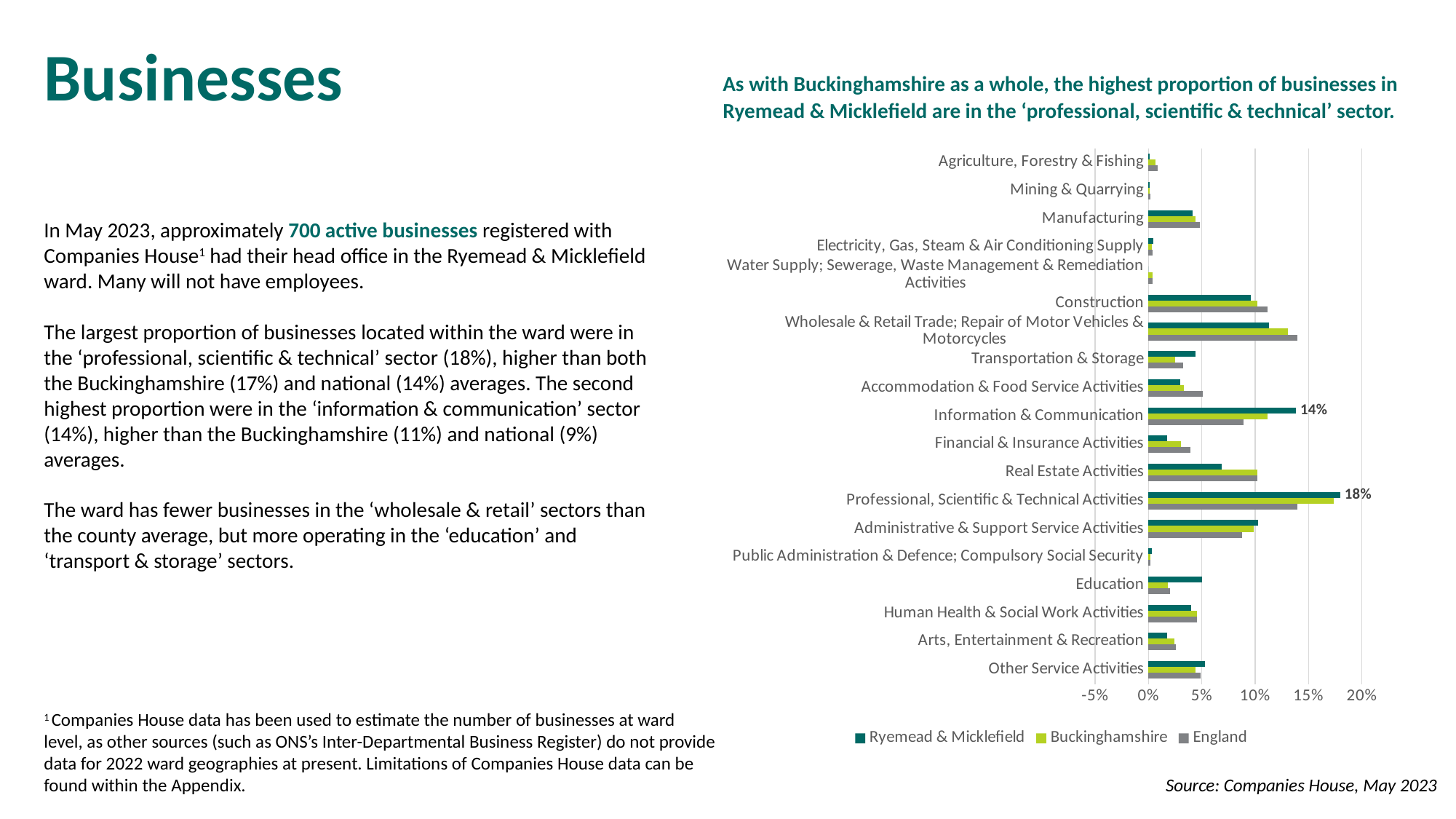
What is the difference between the Ryemead & Micklefield values for Professional, Scientific & Technical Activities and Information & Communication? 4 percentage points How many categories are shown on the chart? 19 Is the Ryemead & Micklefield value for Construction greater or less than 5%? greater Is the England value for Wholesale & Retail Trade; Repair of Motor Vehicles & Motorcycles greater or less than 10%? greater What kind of chart is shown on the slide? Bar chart How many series does the legend list? 3 In the Education category, which is larger: the Ryemead & Micklefield value or the England value? Ryemead & Micklefield Which series is shown in dark teal in the legend? Ryemead & Micklefield What is the value for Ryemead & Micklefield in the Professional, Scientific & Technical Activities category? 18% What is the value for Ryemead & Micklefield in the Information & Communication category? 14% Which category has the highest value for Ryemead & Micklefield? Professional, Scientific & Technical Activities In the Wholesale & Retail Trade; Repair of Motor Vehicles & Motorcycles category, which is larger: the Ryemead & Micklefield value or the Buckinghamshire value? Buckinghamshire